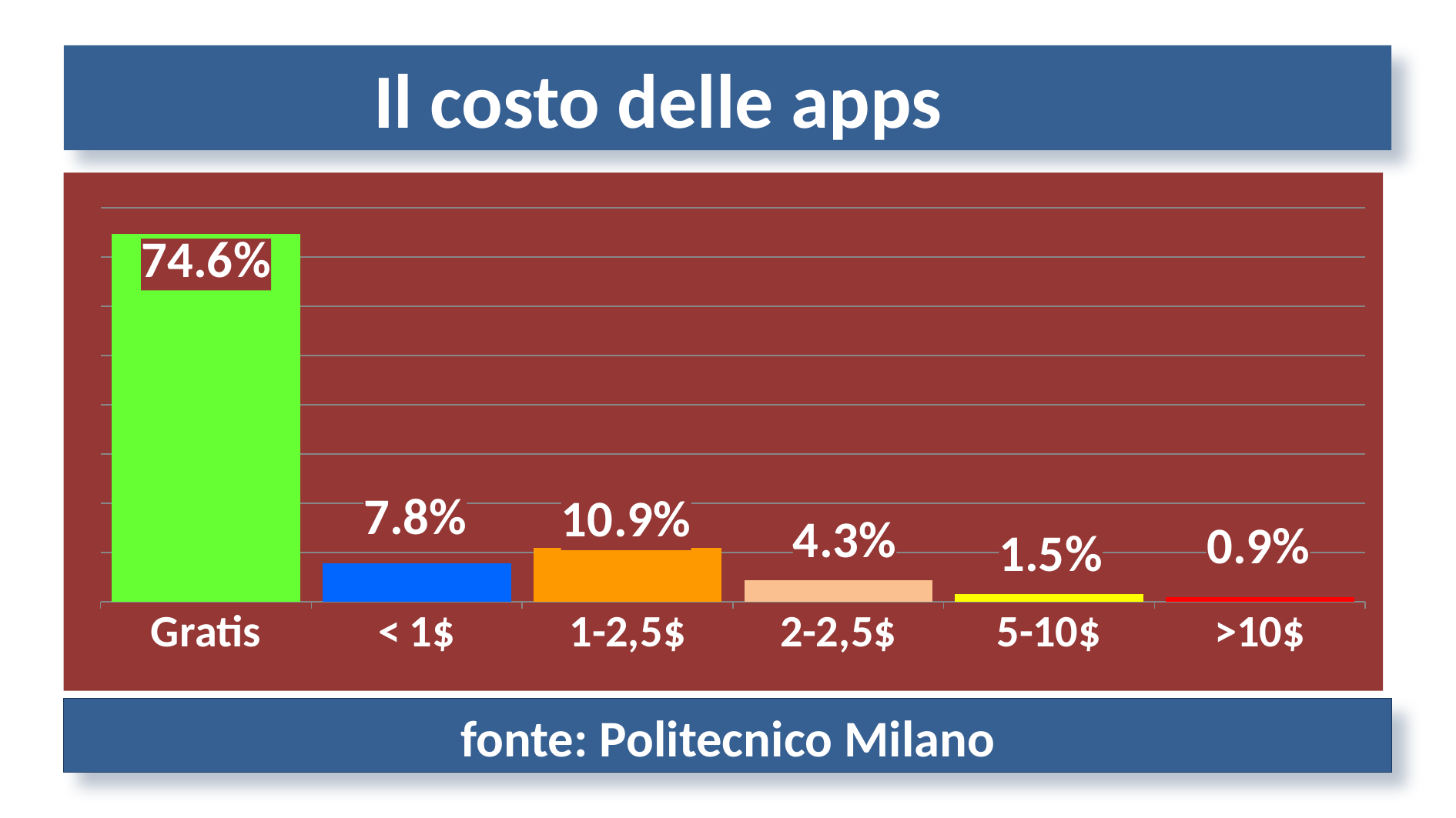
What kind of chart is shown on the slide? Bar chart What is the difference between the values for Gratis and 1-2,5$? 63.7% What is the difference between the values for < 1$ and 2-2,5$? 3.5% What is the value for the 1-2,5$ category? 10.9% What is the value for Gratis? 74.6% How many categories are shown on the x axis? 6 Which category has the lowest value? >10$ Which category has the highest value? Gratis Which is larger, the value for < 1$ or the value for 1-2,5$? 1-2,5$ What is the title of the chart? Il costo delle apps What is the value for the 5-10$ category? 1.5% What is the value for the >10$ category? 0.9%